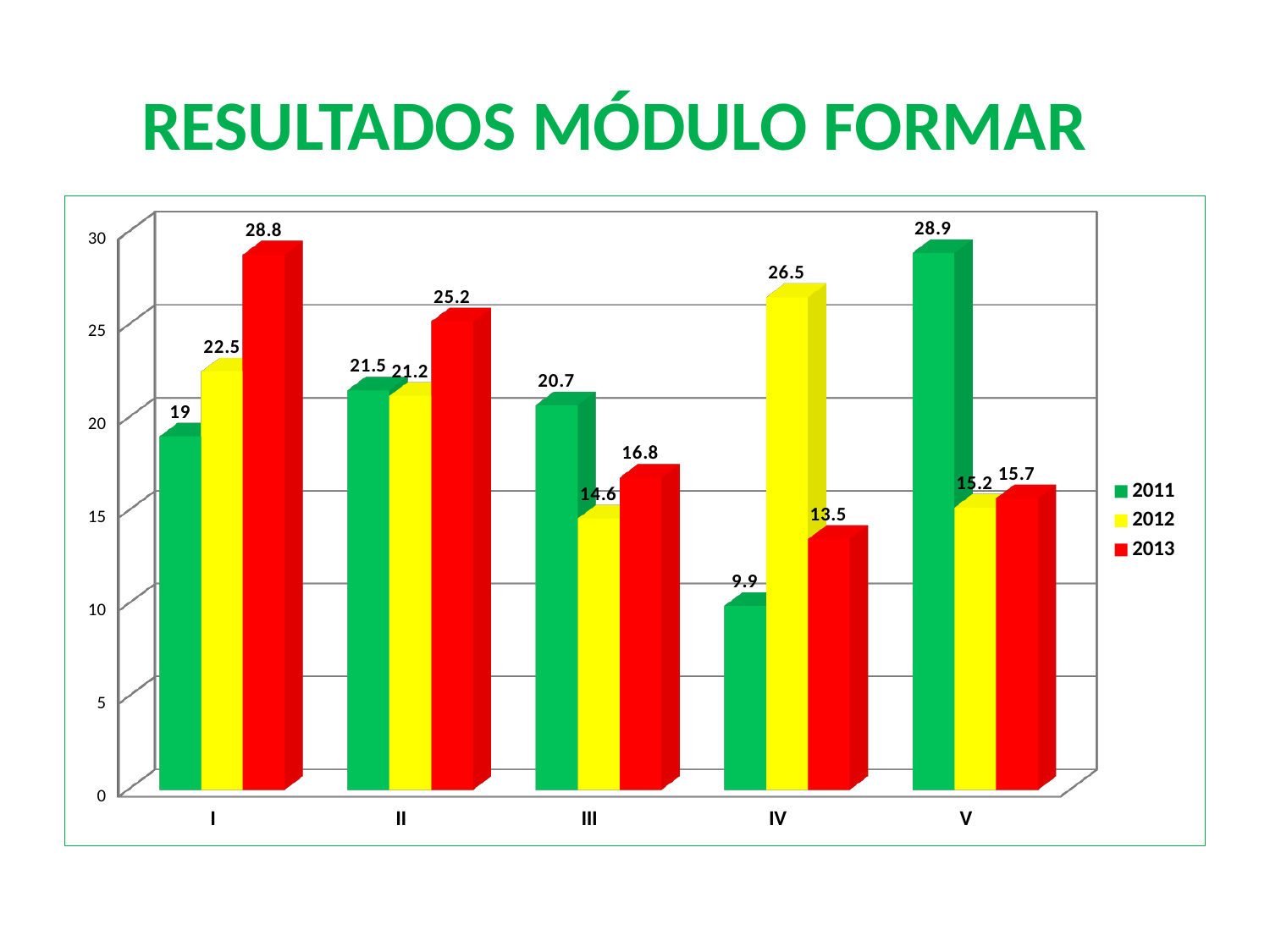
What is the value for 2011 in category IV? 9.9 What kind of chart is shown on the slide? bar chart Which colour represents the 2012 series? yellow What is the title of the slide? RESULTADOS MÓDULO FORMAR Which category has the lowest value for the 2013 series? IV What is the value for 2012 in category III? 14.6 Which is larger in category II: the 2011 value or the 2013 value? 2013 Which category has the highest value for the 2011 series? V How many series does the legend list? 3 What is the difference between the 2012 and 2013 values in category IV? 13 What is the value for 2013 in category I? 28.8 How many categories are shown on the x axis? 5